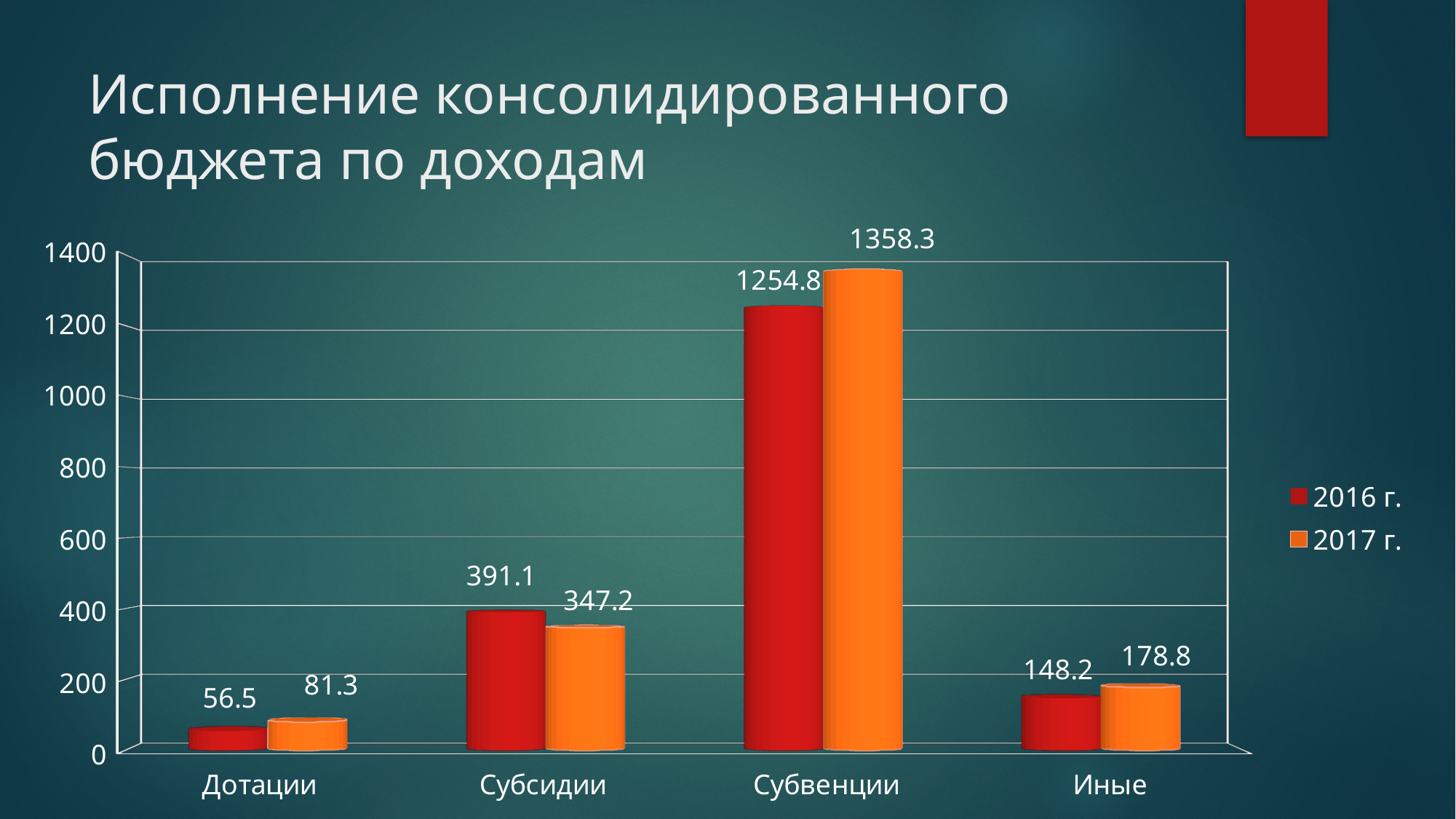
How many series does the legend list? 2 How many categories are shown on the x axis? 4 For Субсидии, which series has the larger value, 2016 г. or 2017 г.? 2016 г. What is the value for Дотации in the 2016 г. series? 56.5 What is the value for Иные in the 2017 г. series? 178.8 Which category has the lowest value in the 2017 г. series? Дотации Which category has the highest value in the 2016 г. series? Субвенции What is the difference between the 2016 г. and 2017 г. values for Субсидии? 43.9 What is the difference between the 2017 г. and 2016 г. values for Субвенции? 103.5 What is the value for Субвенции in the 2017 г. series? 1358.3 Is the value for Иные in the 2016 г. series greater or less than 200? less What kind of chart is shown on the slide? bar chart